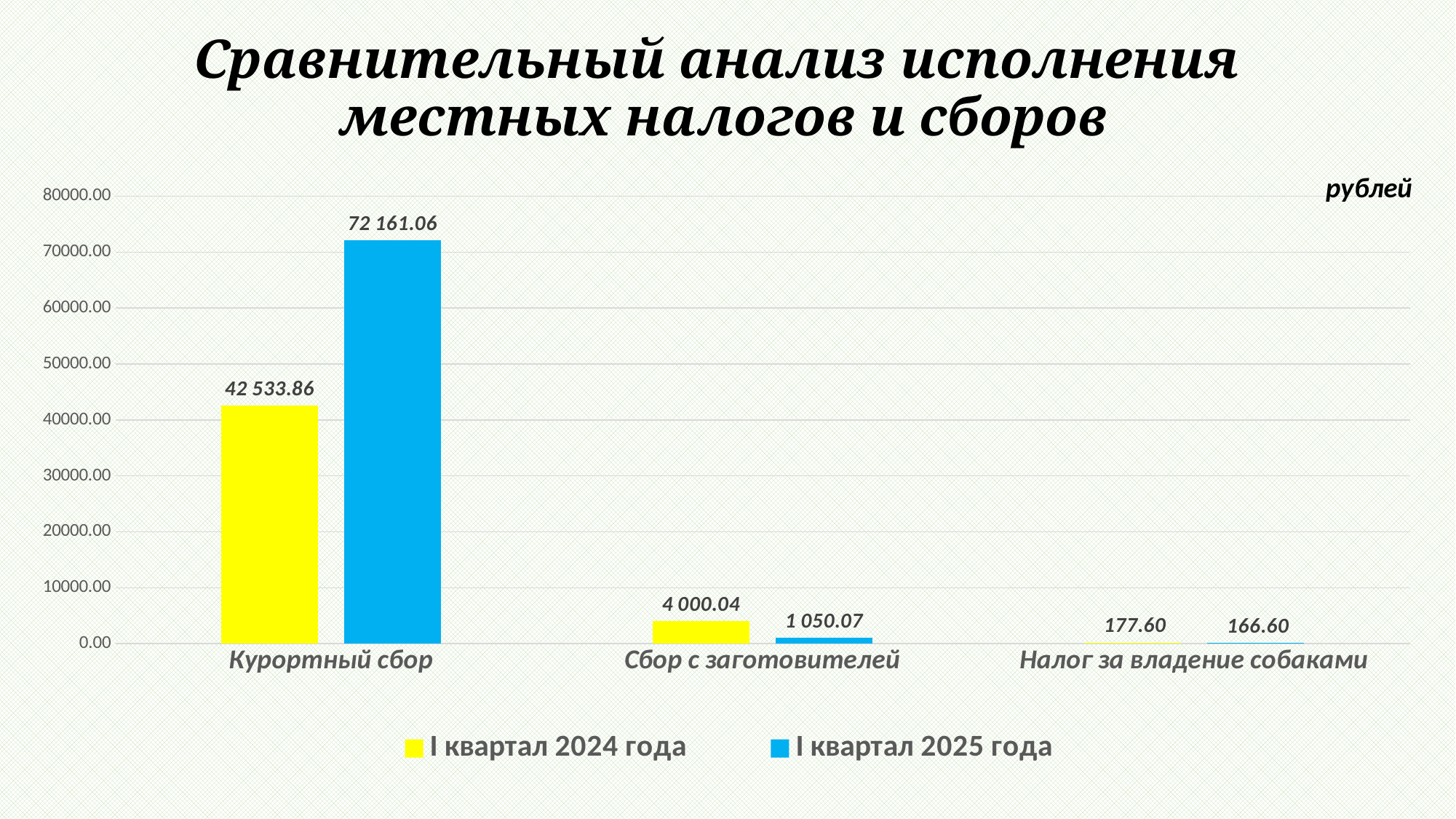
How many categories are shown on the x axis? 3 What is the value for Сбор с заготовителей in the I квартал 2024 года series? 4 000.04 What is the difference between the I квартал 2024 года and I квартал 2025 года values for Сбор с заготовителей? 2 949.97 Which category has the lowest value in the I квартал 2024 года series? Налог за владение собаками What is the value for Налог за владение собаками in the I квартал 2025 года series? 166.60 What is the difference between the I квартал 2025 года and I квартал 2024 года values for Курортный сбор? 29 627.20 Which category has the highest value in the I квартал 2025 года series? Курортный сбор What is the value for Курортный сбор in the I квартал 2024 года series? 42 533.86 What is the value for Курортный сбор in the I квартал 2025 года series? 72 161.06 Which is larger for Сбор с заготовителей: the I квартал 2024 года value or the I квартал 2025 года value? I квартал 2024 года How many series does the legend list? 2 What kind of chart is shown on the slide? Bar chart